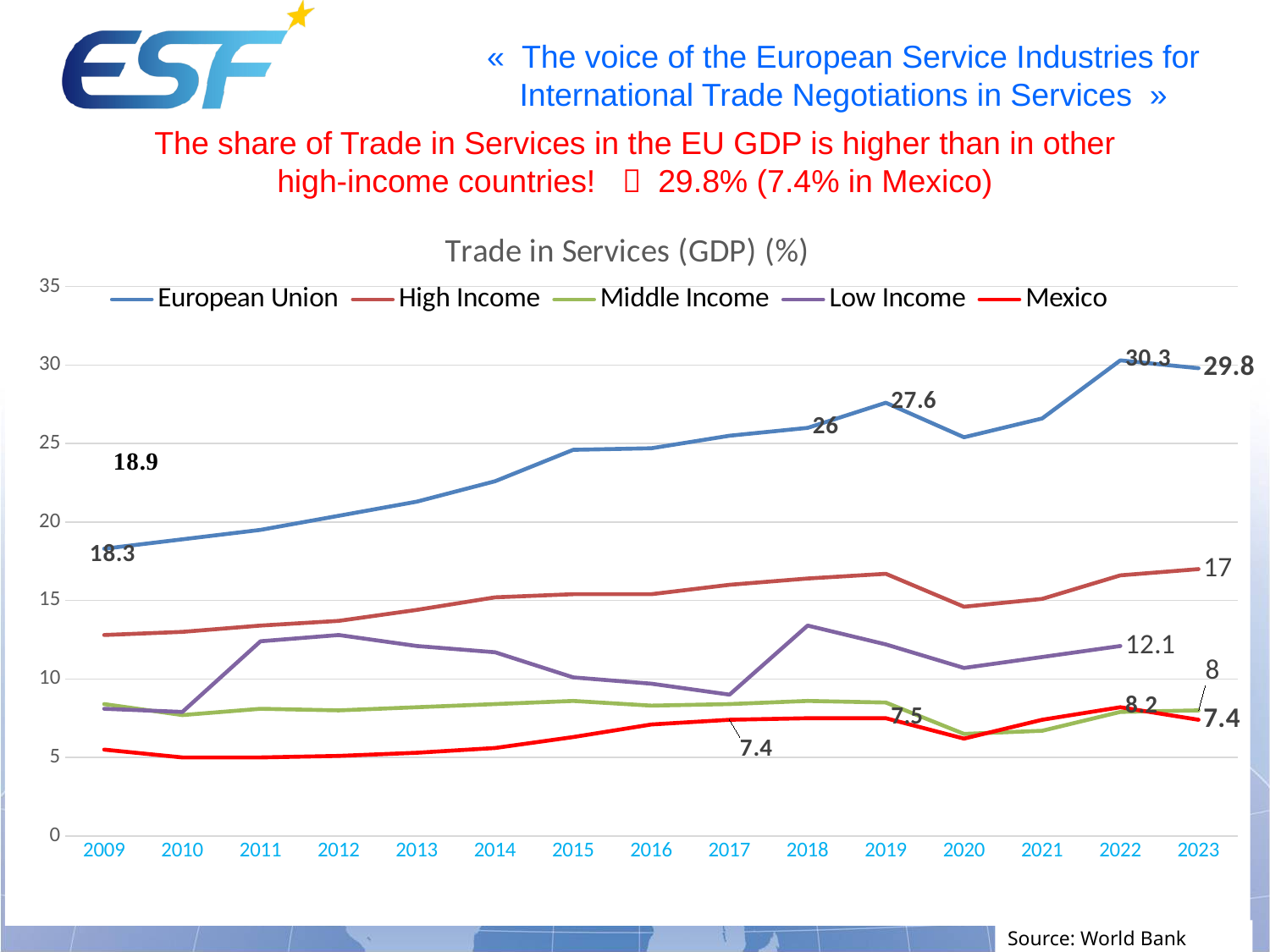
What kind of chart is shown on the slide? line chart What is the value for High Income in 2023? 17 How many years are shown on the x axis of the chart? 15 Which series has the highest value in 2023? European Union Is the value for Low Income in 2018 greater or less than 10? greater What is the difference between the European Union and Mexico values in 2023? 22.4 Does the European Union line generally rise or fall from 2009 to 2023? rise What is the value for the European Union in 2022? 30.3 What is the value for the European Union in 2023? 29.8 What is the value for Mexico in 2023? 7.4 How many series does the legend of the chart list? 5